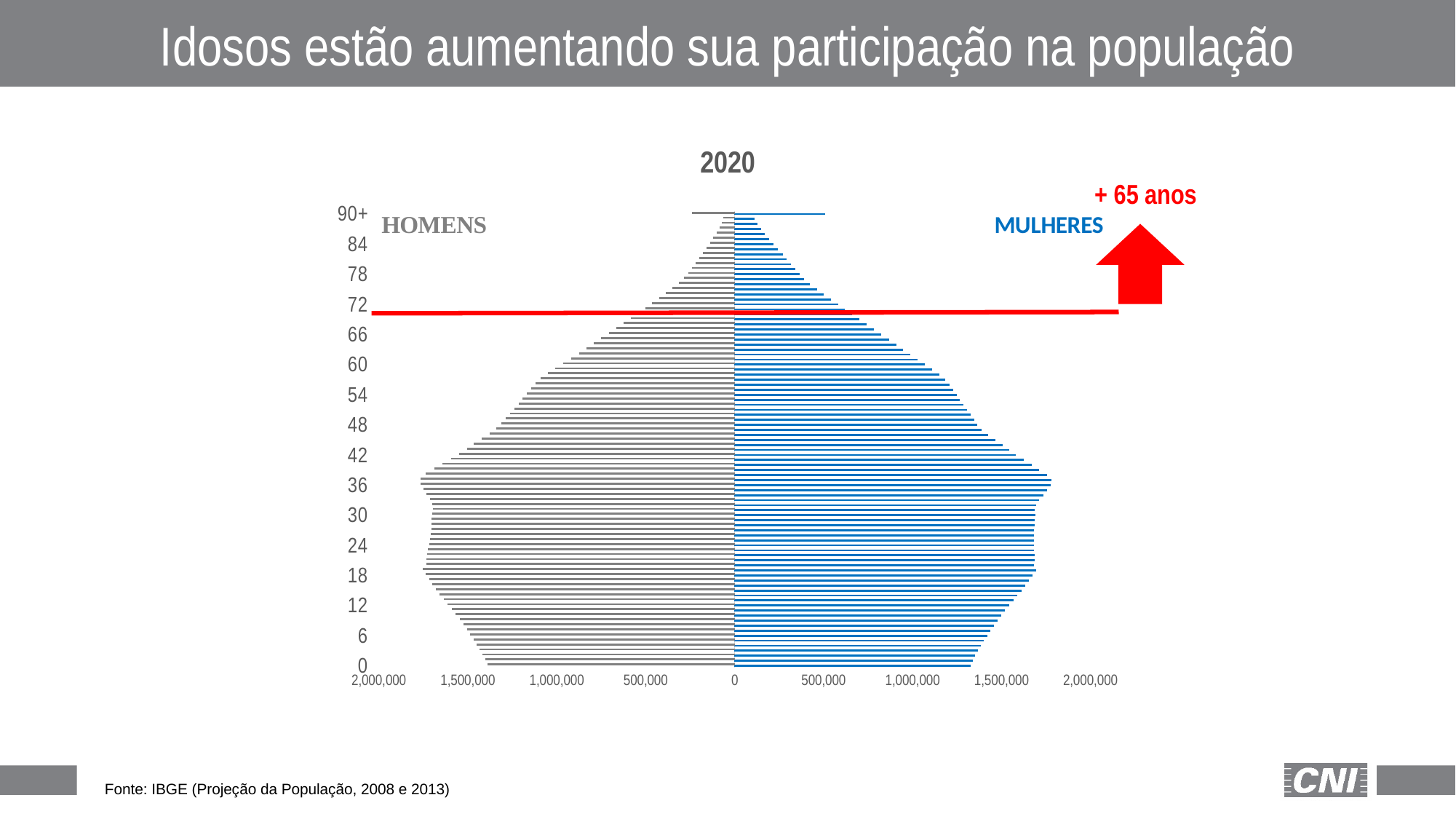
Is the value for MULHERES at age 0 greater or less than 1,000,000? greater From age 42 up to age 90+, do the values for HOMENS rise or fall as age increases? fall Which colour represents MULHERES in the chart? blue What kind of chart is shown on the slide? bar chart At age 90+, which is larger, the value for HOMENS or for MULHERES? MULHERES Is the value for HOMENS at age 84 greater or less than 500,000? less How many series does the chart show? 2 Is the value for HOMENS at age 54 greater or less than 1,000,000? greater What is the title of the chart? 2020